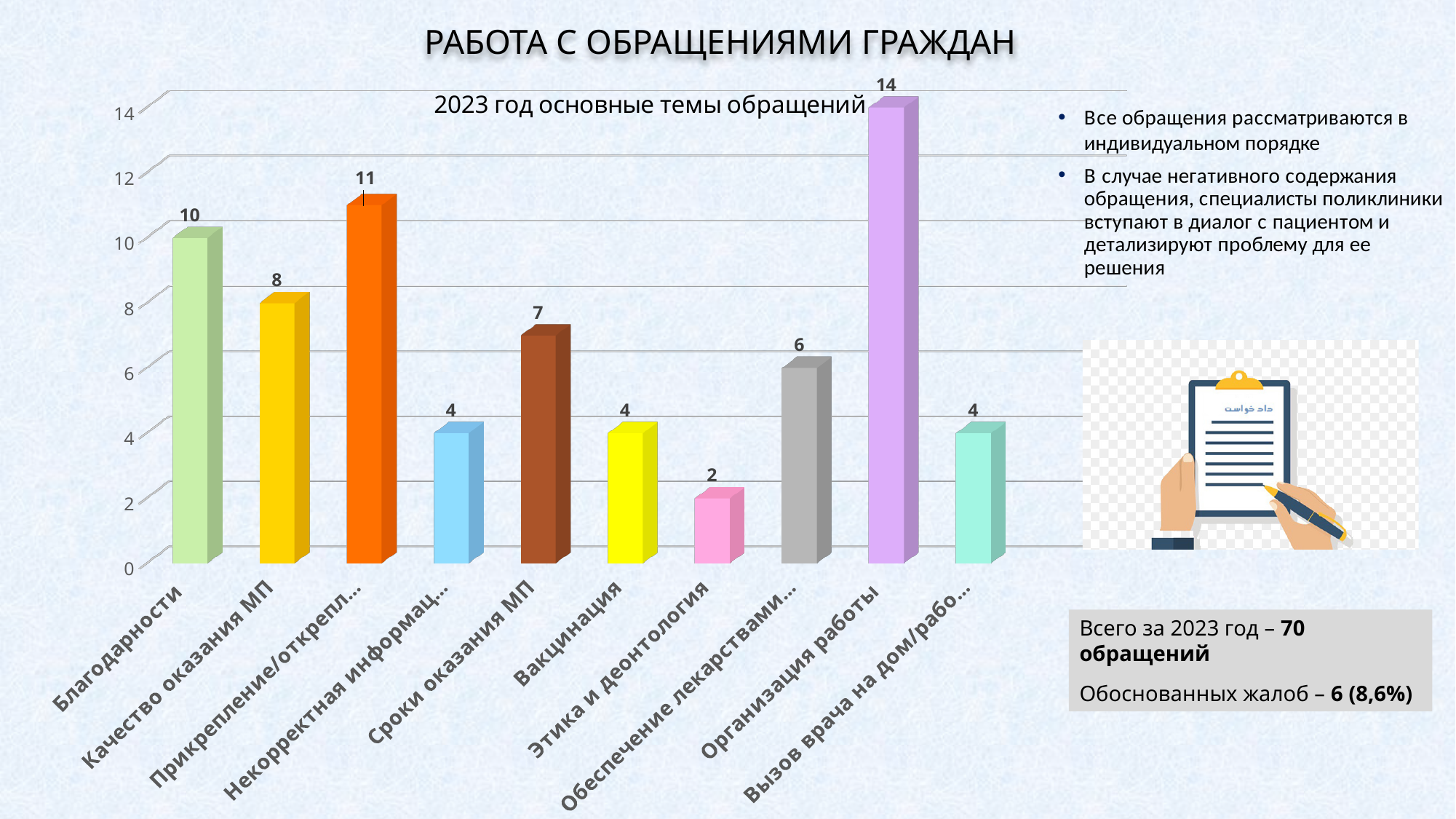
What is the difference between the values for Организация работы and Благодарности? 4 What is the value for Этика и деонтология? 2 Which is larger, the value for Вакцинация or the value for Сроки оказания МП? Сроки оказания МП What is the value for Благодарности? 10 What is the title of the chart? 2023 год основные темы обращений Which category has the highest value? Организация работы How many categories are shown in the chart? 10 What is the value for Сроки оказания МП? 7 Is the value for Организация работы greater or less than 12? greater What is the value for Качество оказания МП? 8 Which category has the lowest value? Этика и деонтология What kind of chart is shown on the slide? bar chart